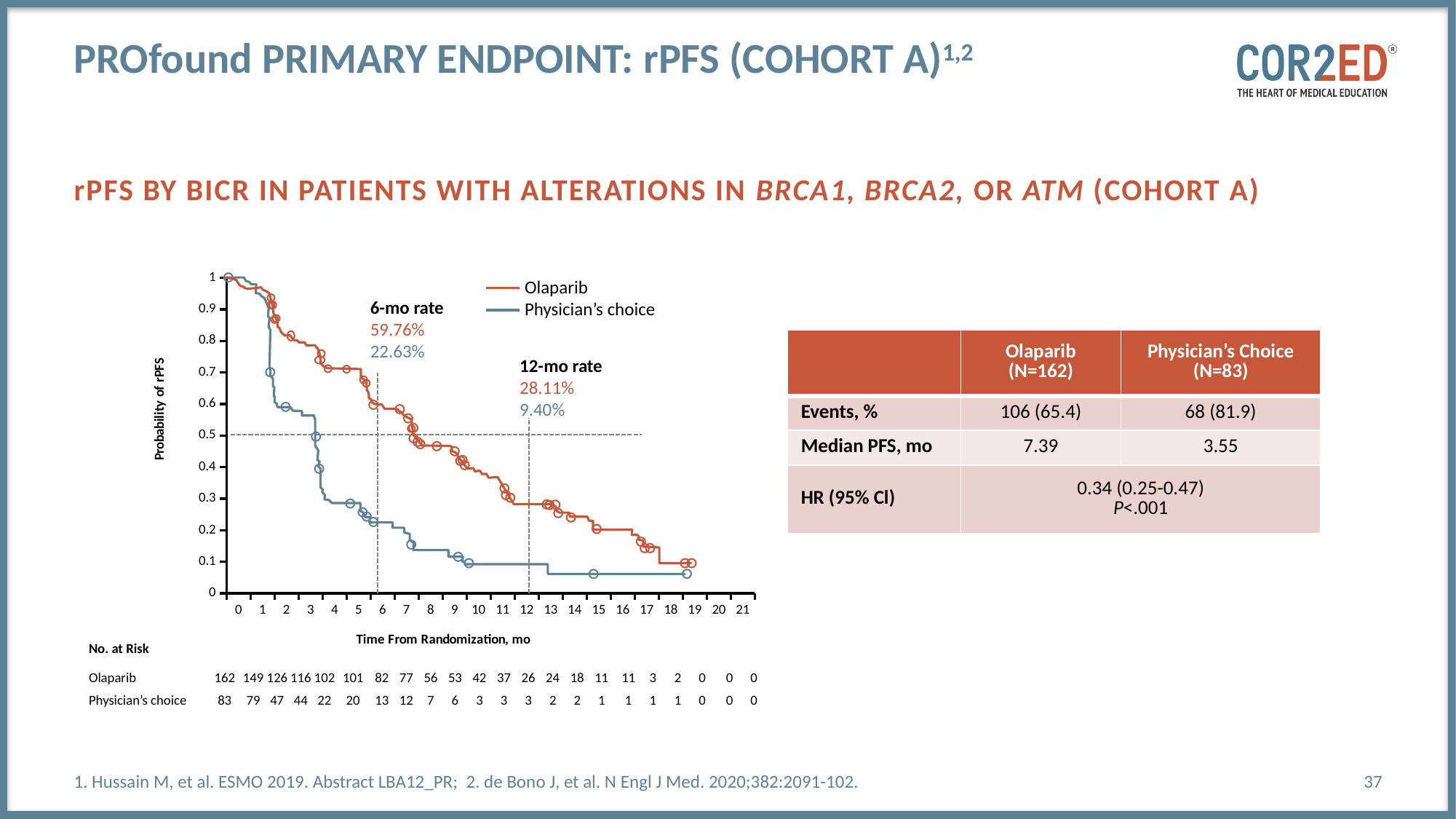
What is the 6-month rPFS rate shown for Physician's choice? 22.63% What kind of chart is shown on the slide? Line chart (Kaplan-Meier curve) What is the label of the y-axis of the chart? Probability of rPFS What is the 12-month rPFS rate shown for Olaparib? 28.11% Is the probability of rPFS for Physician's choice at 6 months greater or less than 0.5? less What is the 12-month rPFS rate shown for Physician's choice? 9.40% Do the curves rise or fall as time from randomization increases? Fall Which arm has the higher 12-month rPFS rate, Olaparib or Physician's choice? Olaparib What is the 6-month rPFS rate shown for Olaparib? 59.76% What is the difference between the 6-month rPFS rates for Olaparib and Physician's choice? 37.13 percentage points How many series does the chart legend list? 2 What is the difference between the 12-month rPFS rates for Olaparib and Physician's choice? 18.71 percentage points